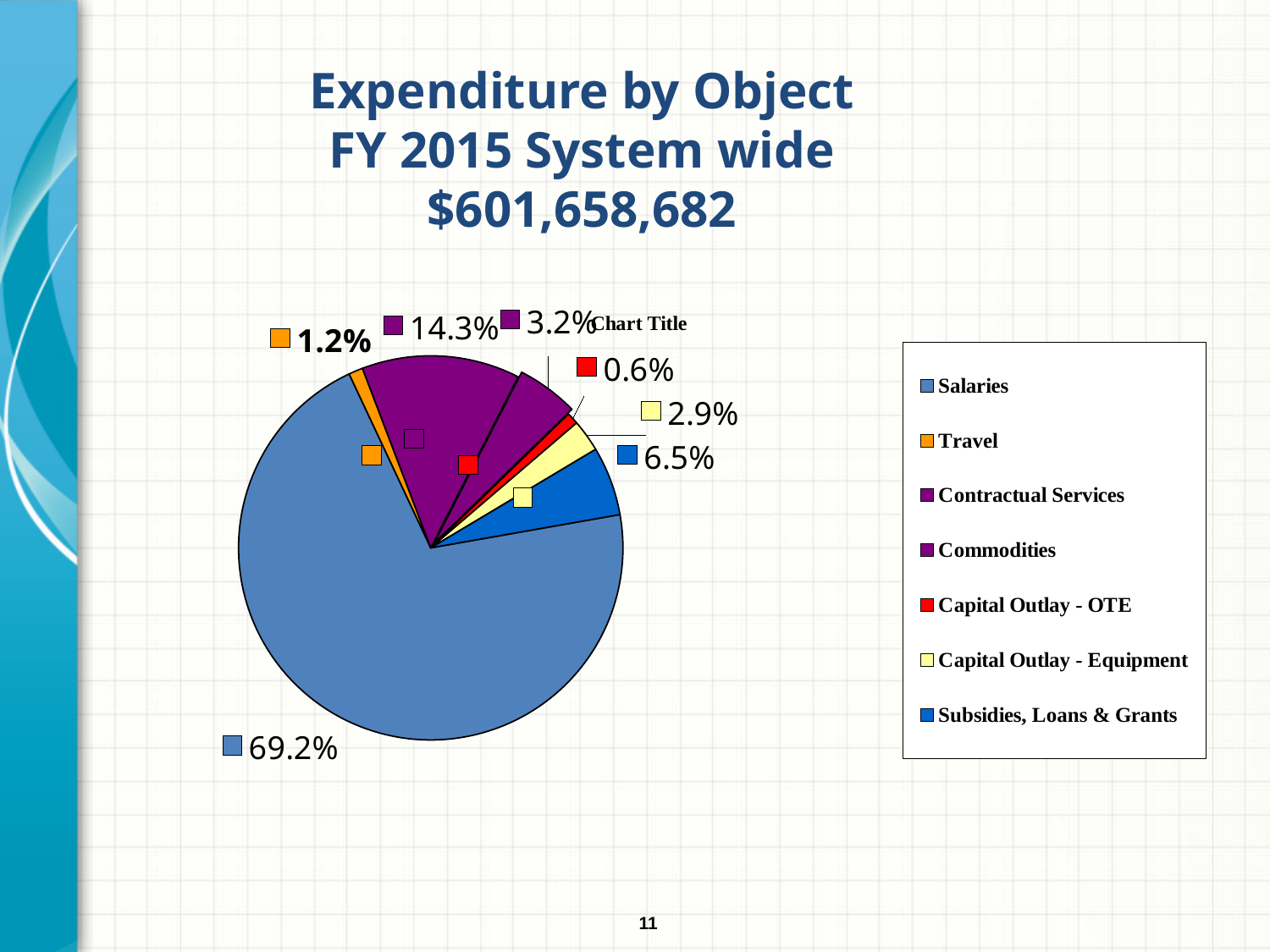
What percentage of expenditure is Capital Outlay - Equipment? 2.9% What percentage of expenditure is Subsidies, Loans & Grants? 6.5% Which is larger, the share for Commodities or the share for Capital Outlay - Equipment? Commodities What total expenditure amount is given in the slide title? $601,658,682 Which category has the largest share of the pie? Salaries How many categories does the legend list? 7 What percentage of expenditure is Travel? 1.2% What is the difference in percentage points between Contractual Services and Commodities? 11.1 Which category has the smallest share of the pie? Capital Outlay - OTE What type of chart is shown on the slide? Pie chart What percentage of expenditure is Contractual Services? 14.3% What percentage of expenditure is Salaries? 69.2%